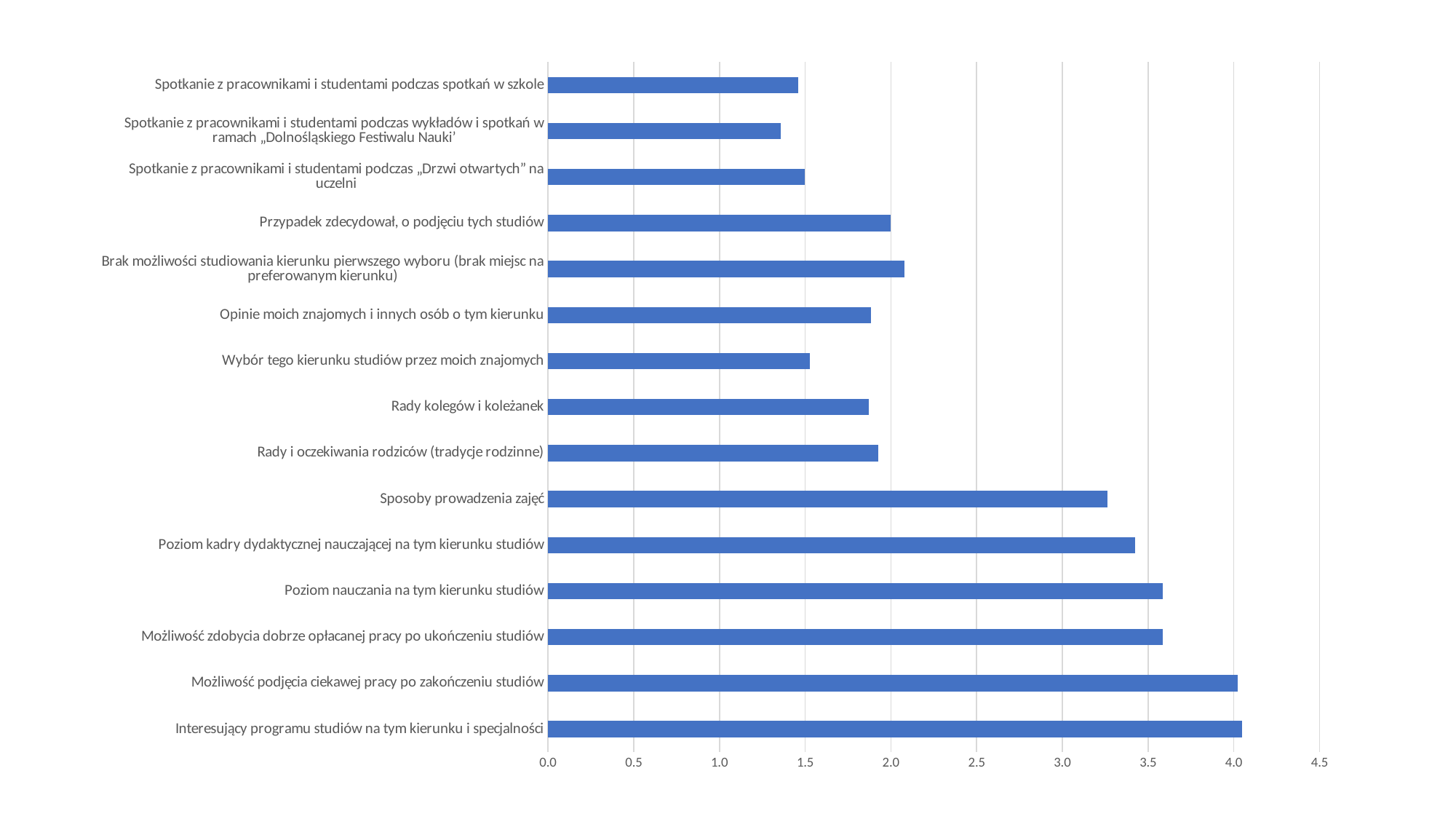
Is the value for "Opinie moich znajomych i innych osób o tym kierunku" greater or less than 2.0? less Is the value for "Sposoby prowadzenia zajęć" greater or less than 3.0? greater Is the value for "Spotkanie z pracownikami i studentami podczas wykładów i spotkań w ramach „Dolnośląskiego Festiwalu Nauki"" greater or less than 1.5? less What kind of chart is shown on the slide? bar chart How many categories are plotted in the chart? 15 Which is larger: the value for "Poziom kadry dydaktycznej nauczającej na tym kierunku studiów" or for "Sposoby prowadzenia zajęć"? Poziom kadry dydaktycznej nauczającej na tym kierunku studiów What colour are the bars in the chart? blue Which is larger: the value for "Brak możliwości studiowania kierunku pierwszego wyboru (brak miejsc na preferowanym kierunku)" or for "Opinie moich znajomych i innych osób o tym kierunku"? Brak możliwości studiowania kierunku pierwszego wyboru (brak miejsc na preferowanym kierunku) Which is larger: the value for "Przypadek zdecydował, o podjęciu tych studiów" or for "Rady kolegów i koleżanek"? Przypadek zdecydował, o podjęciu tych studiów What is the highest value shown on the horizontal axis of the chart? 4.5